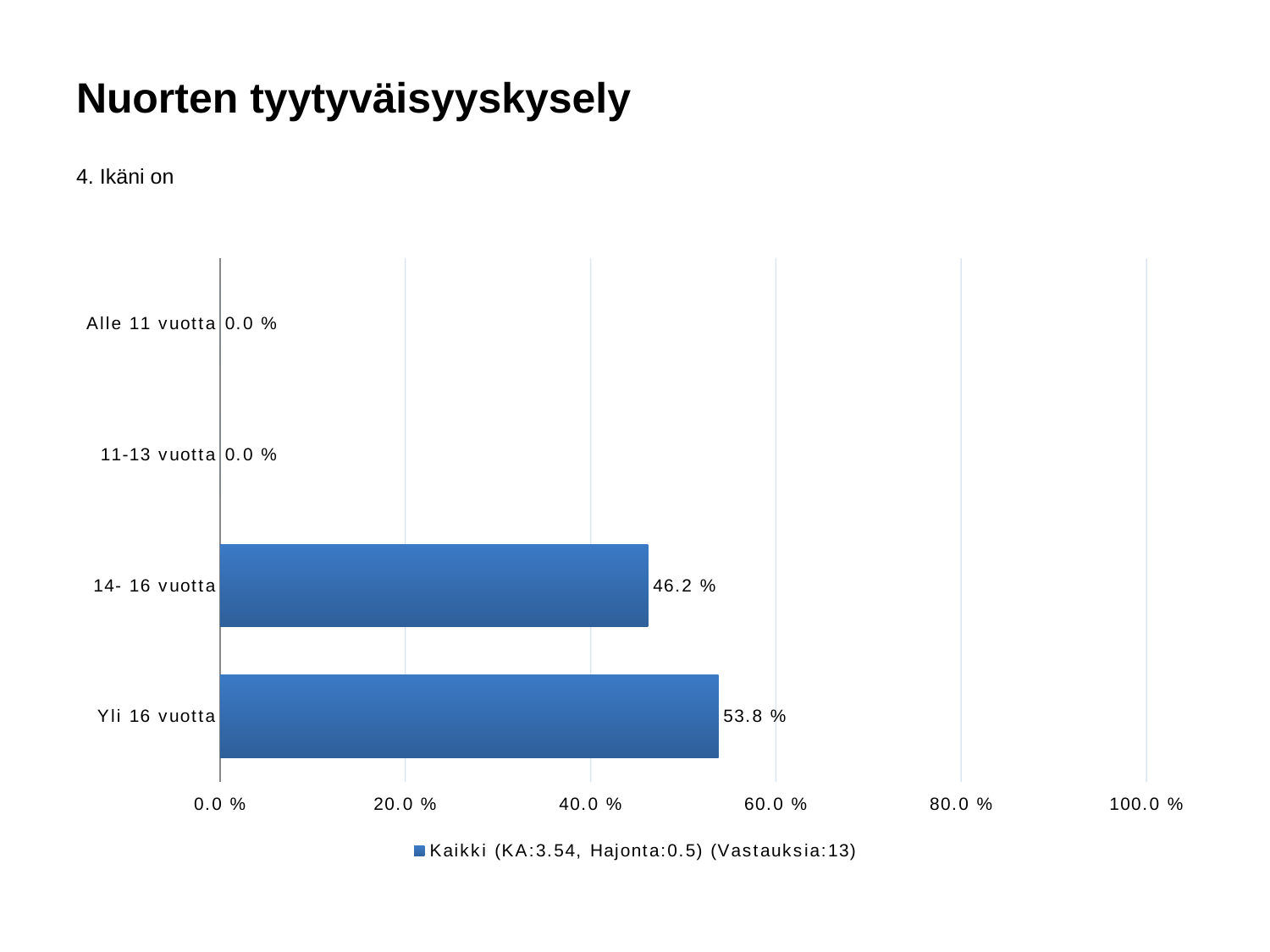
What is the value for "11-13 vuotta"? 0.0 % Is the value for "14- 16 vuotta" greater or less than 40.0 %? greater What is the value for "Alle 11 vuotta"? 0.0 % What is the value for "14- 16 vuotta"? 46.2 % Which category has the highest value? Yli 16 vuotta What is the difference between the values for "Yli 16 vuotta" and "14- 16 vuotta"? 7.6 % Is the value for "Yli 16 vuotta" greater or less than 60.0 %? less What kind of chart is shown on the slide? Bar chart What is the value for "Yli 16 vuotta"? 53.8 % How many categories are shown on the chart? 4 What is the legend entry for the series shown on the chart? Kaikki (KA:3.54, Hajonta:0.5) (Vastauksia:13) Which is larger, the value for "Yli 16 vuotta" or the value for "14- 16 vuotta"? Yli 16 vuotta